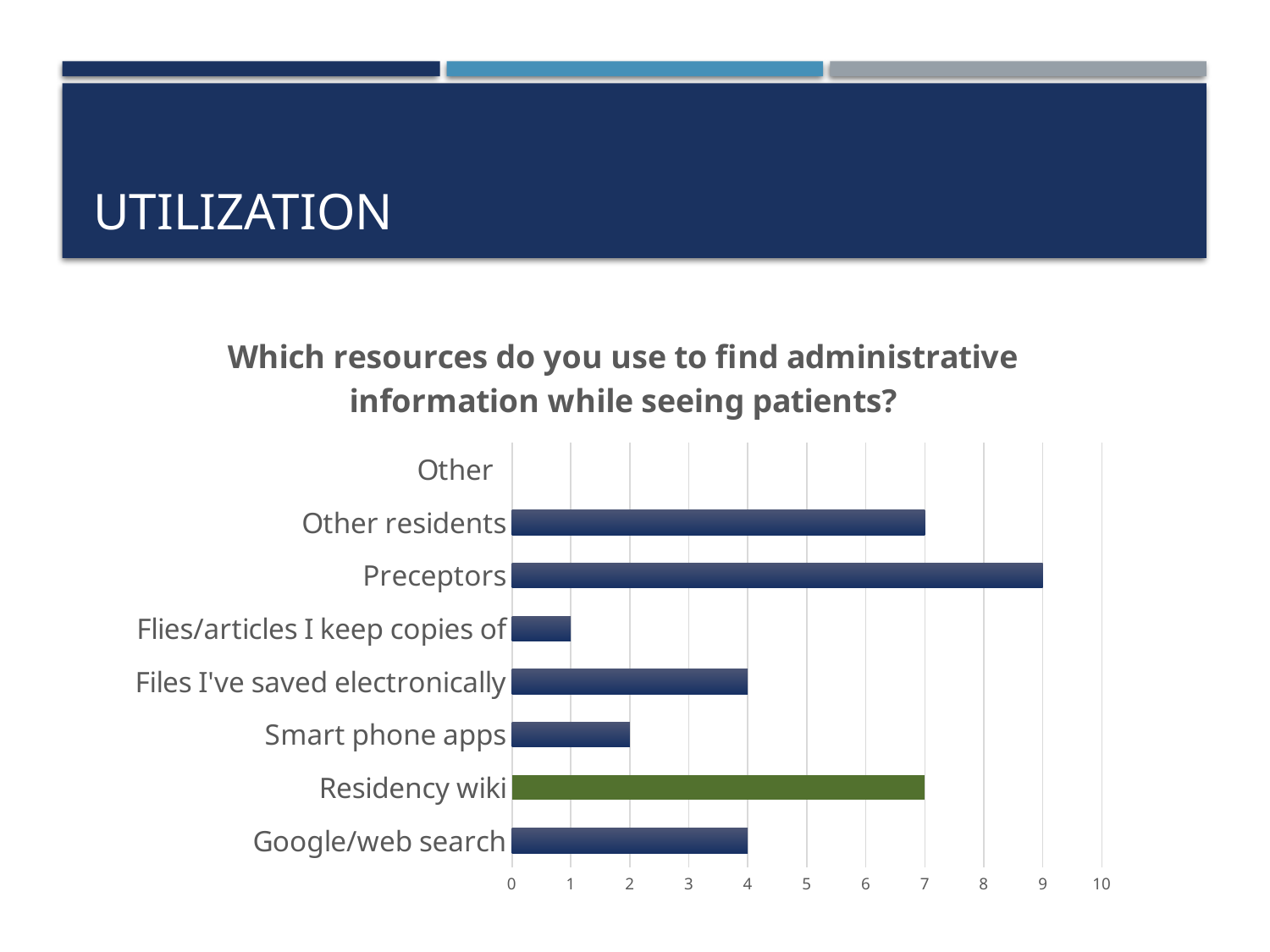
How many categories are shown on the chart? 8 Which bar is coloured green rather than dark blue? Residency wiki What is the value for Residency wiki? 7 What type of chart is shown on the slide? bar chart What is the value for Flies/articles I keep copies of? 1 What is the title of the chart? Which resources do you use to find administrative information while seeing patients? Is the value for Preceptors greater or less than 8? greater What is the difference between the values for Preceptors and Other residents? 2 Which is larger, the value for Residency wiki or the value for Google/web search? Residency wiki What is the value for Preceptors? 9 What is the value for Smart phone apps? 2 Which category has the highest value? Preceptors